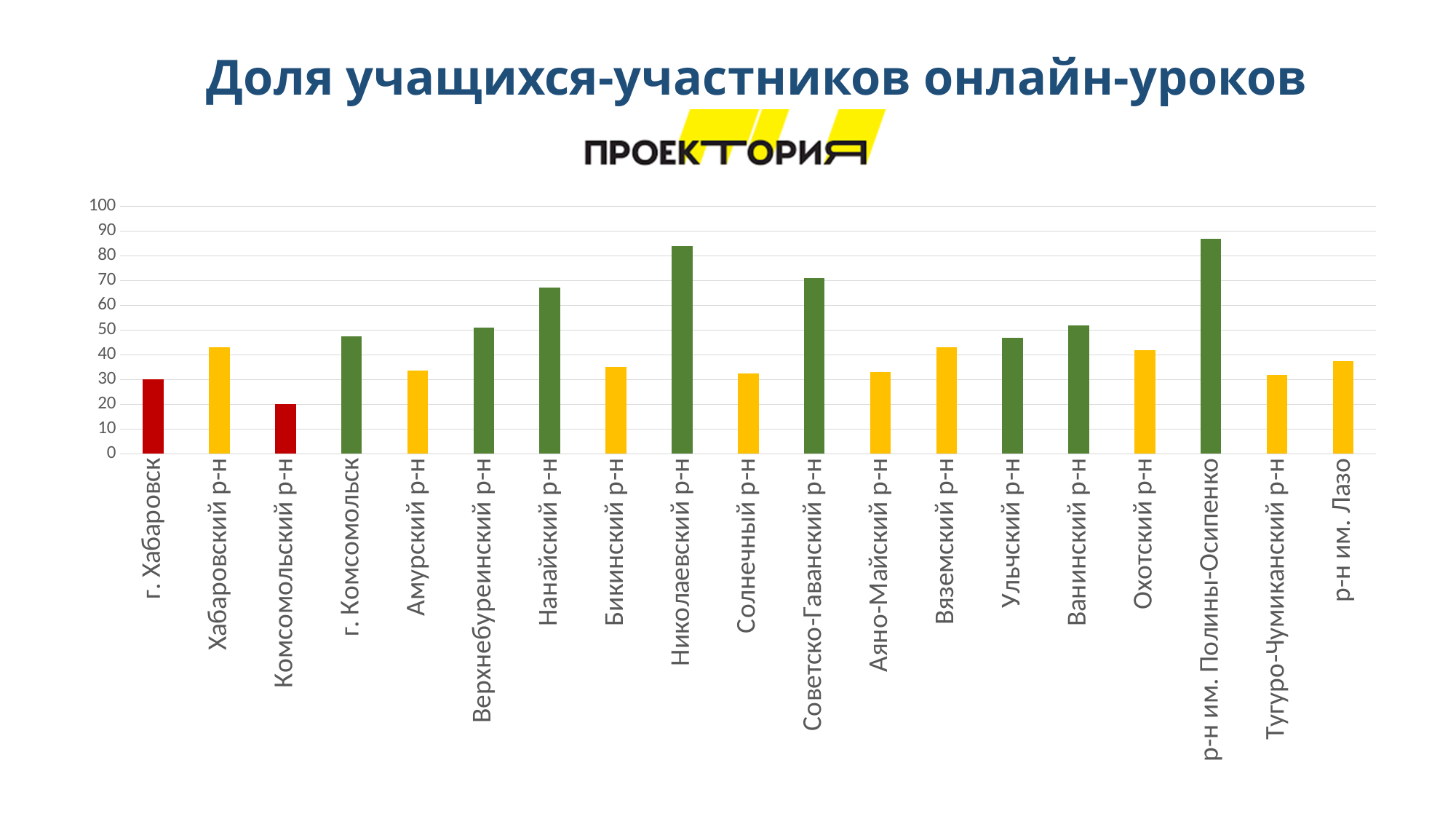
Is the value for Нанайский р-н greater or less than 60? greater Which is larger, the value for Нанайский р-н or for Советско-Гаванский р-н? Советско-Гаванский р-н Which is larger, the value for г. Хабаровск or for Хабаровский р-н? Хабаровский р-н Is the value for Бикинский р-н greater or less than 40? less Which category has the lowest bar? Комсомольский р-н How many categories (districts/cities) are shown on the x axis? 19 Is the value for Николаевский р-н greater or less than 80? greater What is the title of the chart? Доля учащихся-участников онлайн-уроков What kind of chart is shown on the slide? bar chart Which category has the highest bar? р-н им. Полины-Осипенко How many bars are coloured red? 2